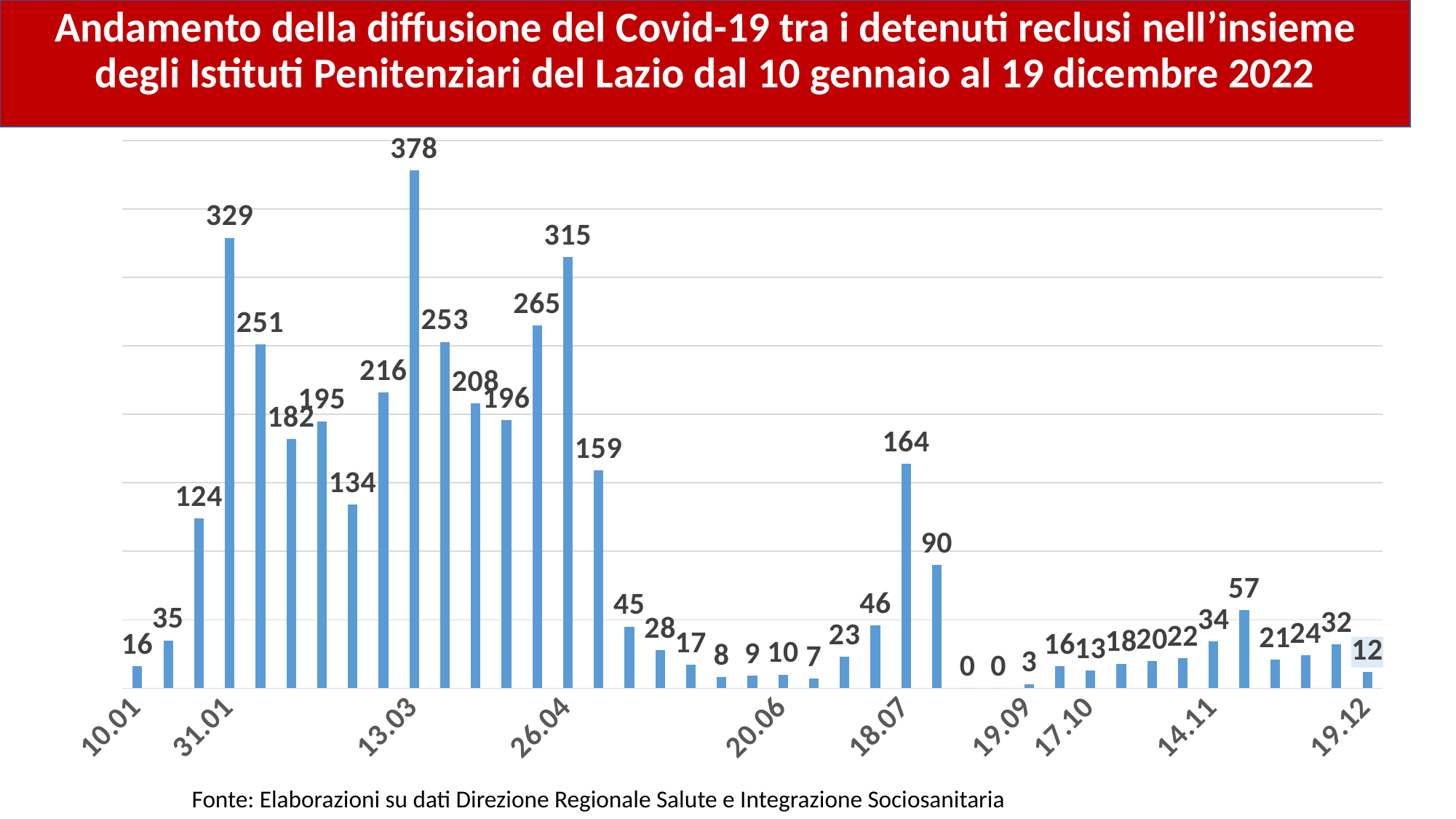
What is the value for 18.07? 164 What is the highest value shown in the chart? 378 Do the values generally rise or fall from 26.04 to 20.06? fall Which date has the highest value? 13.03 What is the lowest value shown in the chart? 0 What is the difference between the value for 13.03 and the value for 26.04? 63 How many bars are plotted in the chart? 41 Which is larger, the value for 31.01 or the value for 26.04? 31.01 What type of chart is shown on the slide? bar chart What is the value for 26.04? 315 What is the value for 19.12? 12 What is the value for 10.01? 16